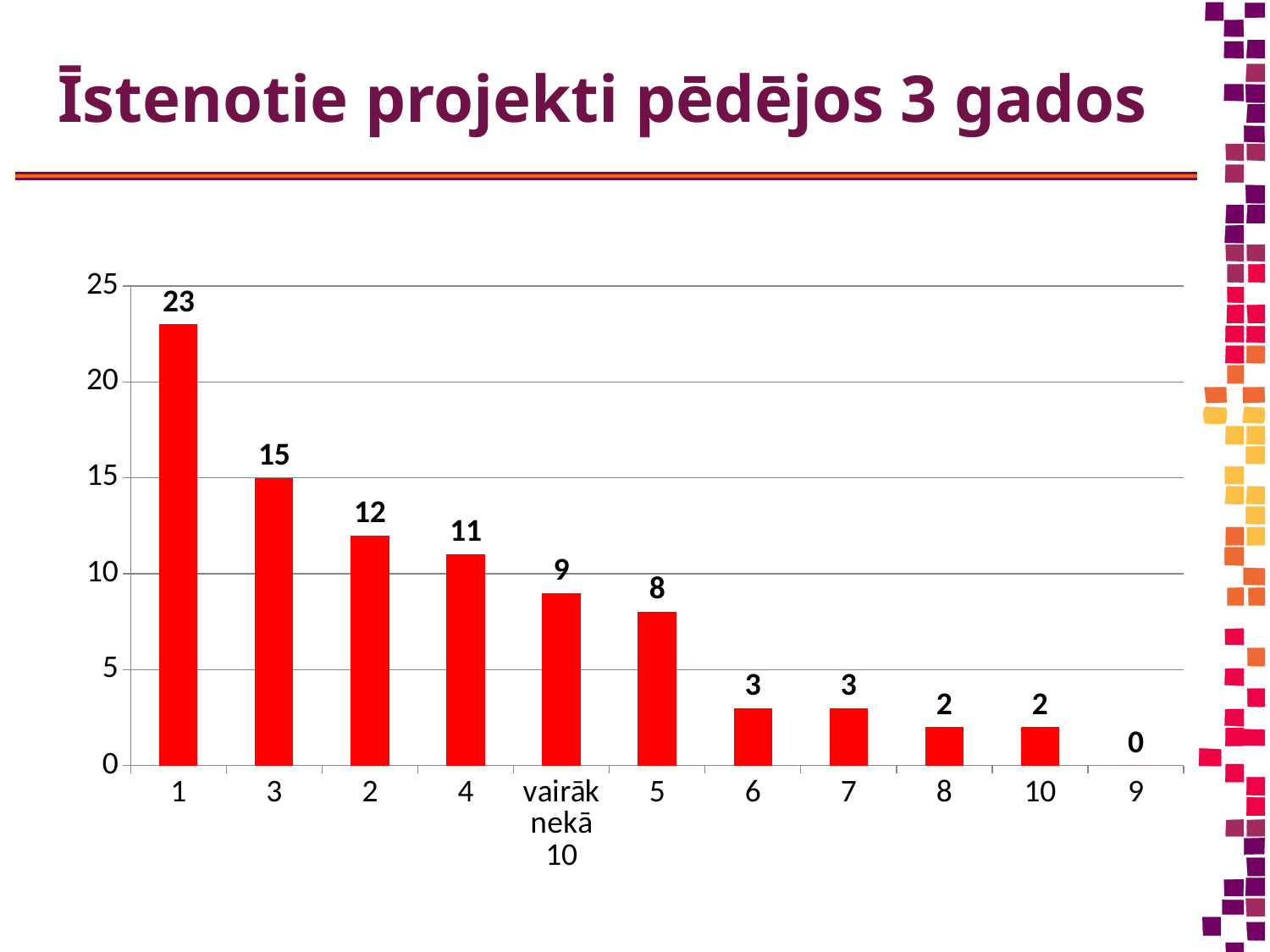
What is the value for category "1"? 23 Do the values generally rise or fall from left to right along the x axis? fall How many categories are shown on the x axis? 11 Which is larger, the value for category "2" or the value for category "4"? 2 What is the difference between the values for categories "1" and "3"? 8 What kind of chart is shown on the slide? bar chart Which category has the lowest value? 9 What is the title of the slide? Īstenotie projekti pēdējos 3 gados Is the value for category "3" greater or less than 10? greater What is the value for category "vairāk nekā 10"? 9 Which category has the highest value? 1 What is the value for category "5"? 8